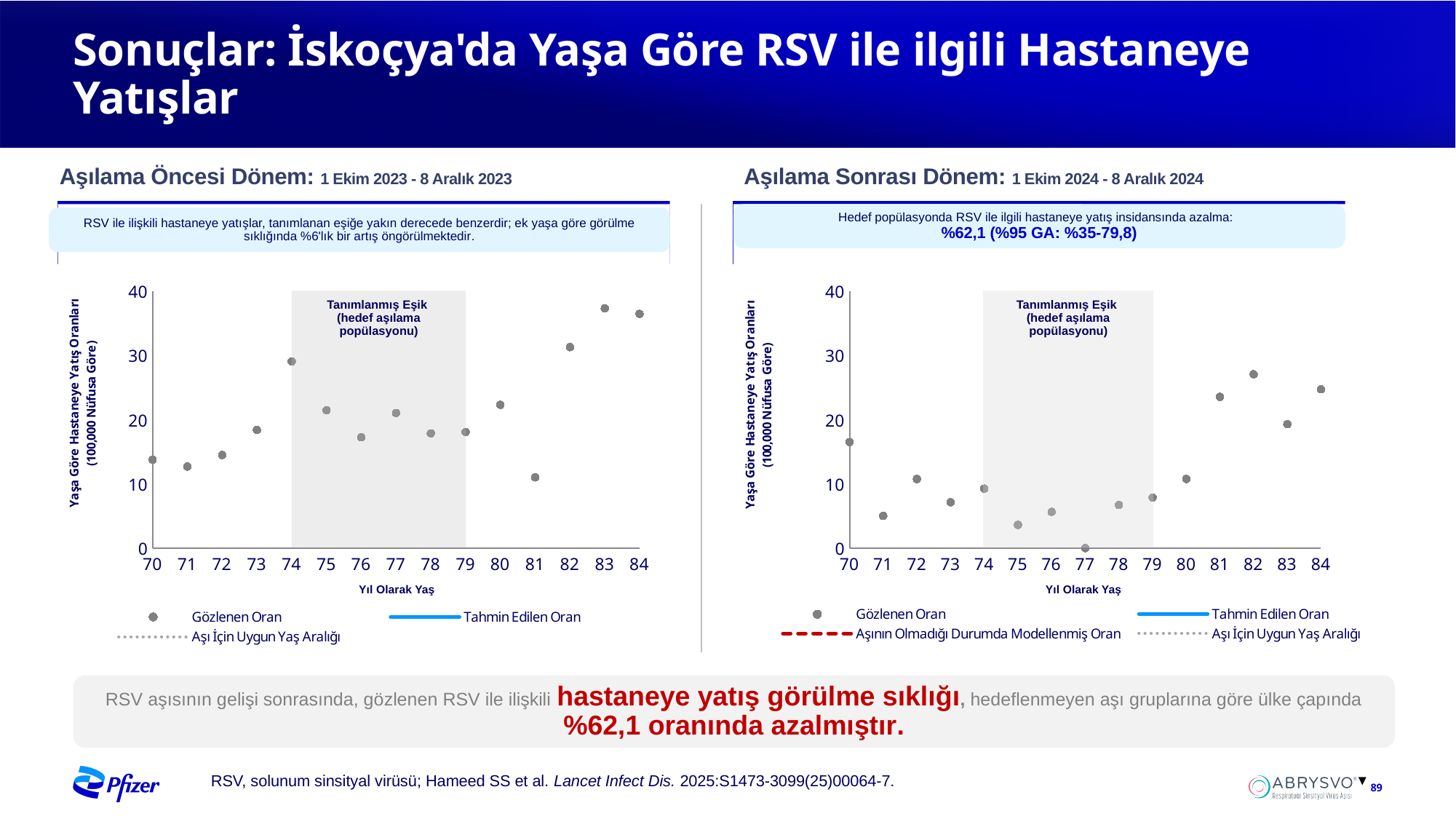
In the right chart (Aşılama Sonrası Dönem), which age has the lowest observed rate? 77 How many entries does the legend of the left chart (Aşılama Öncesi Dönem) list? 3 In the right chart (Aşılama Sonrası Dönem), is the observed rate for age 84 greater or less than 20? greater In the left chart (Aşılama Öncesi Dönem), is the observed rate for age 83 greater or less than 30? greater What is the x-axis title of the right chart (Aşılama Sonrası Dönem)? Yıl Olarak Yaş How many entries does the legend of the right chart (Aşılama Sonrası Dönem) list? 4 In the left chart (Aşılama Öncesi Dönem), how many ages are plotted on the x axis? 15 In the right chart (Aşılama Sonrası Dönem), which age has the highest observed rate? 82 In the left chart (Aşılama Öncesi Dönem), which is larger, the observed rate for age 74 or for age 75? age 74 In the right chart (Aşılama Sonrası Dönem), which is larger, the observed rate for age 70 or for age 71? age 70 In the left chart (Aşılama Öncesi Dönem), is the observed rate for age 70 greater or less than 20? less What kind of chart is the left chart (Aşılama Öncesi Dönem)? scatter chart